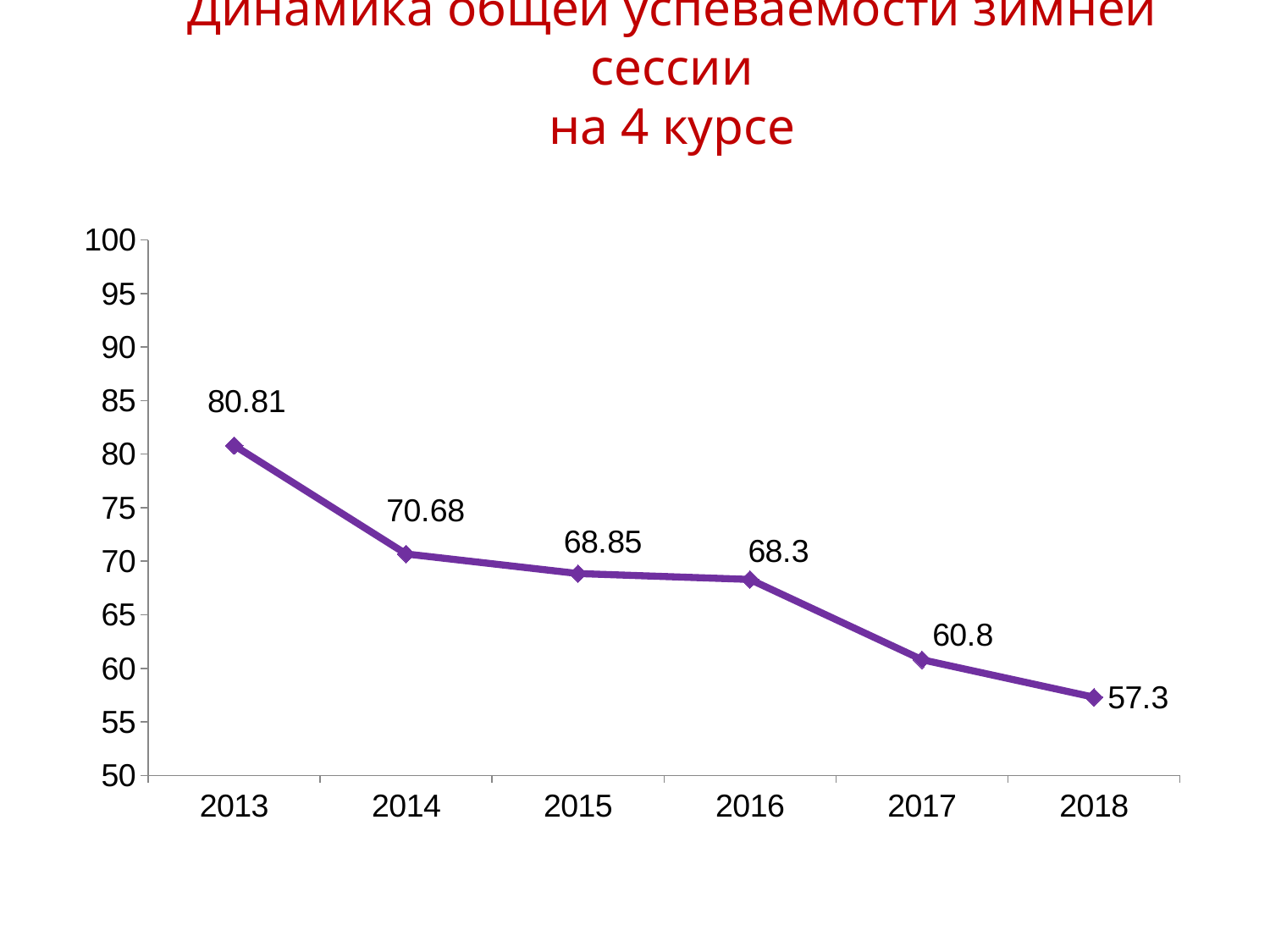
Is the value for 2015 greater or less than 65? greater Which is larger, the value for 2014 or the value for 2017? 2014 What kind of chart is shown on the slide? line chart What is the value for 2018? 57.3 Do the values rise or fall from 2013 to 2018? fall What is the difference between the values for 2013 and 2014? 10.13 Which year has the highest value? 2013 What is the difference between the values for 2017 and 2018? 3.5 Which year has the lowest value? 2018 What is the value for 2013? 80.81 How many years are plotted on the chart? 6 What is the value for 2016? 68.3